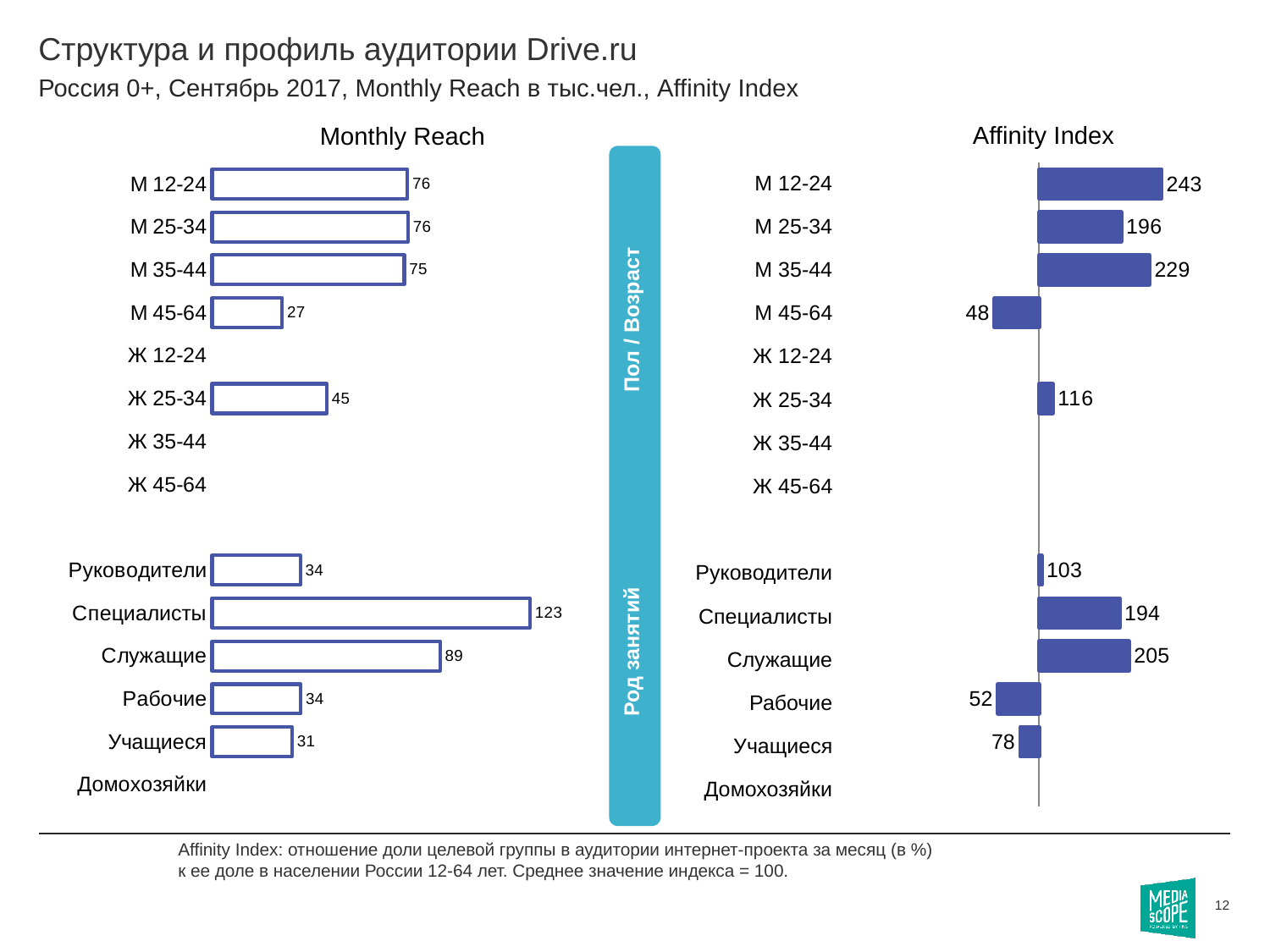
In the Monthly Reach chart, which is larger, Ж 25-34 or М 45-64? Ж 25-34 In the Affinity Index chart, what is the value for М 35-44? 229 In the Affinity Index chart, what is the difference between М 12-24 and М 25-34? 47 What kind of chart is the Affinity Index chart? Bar chart In the Affinity Index chart, which category has the highest value? М 12-24 In the Affinity Index chart, which category has the lowest value among those with a bar? М 45-64 In the Monthly Reach chart, what is the value for М 45-64? 27 In the Monthly Reach chart, what is the difference between Специалисты and Служащие? 34 In the Monthly Reach chart, which category has the highest value? Специалисты In the Monthly Reach chart, what is the value for Специалисты? 123 In the Affinity Index chart, which is larger, Специалисты or Служащие? Служащие In the Affinity Index chart, what is the value for Учащиеся? 78